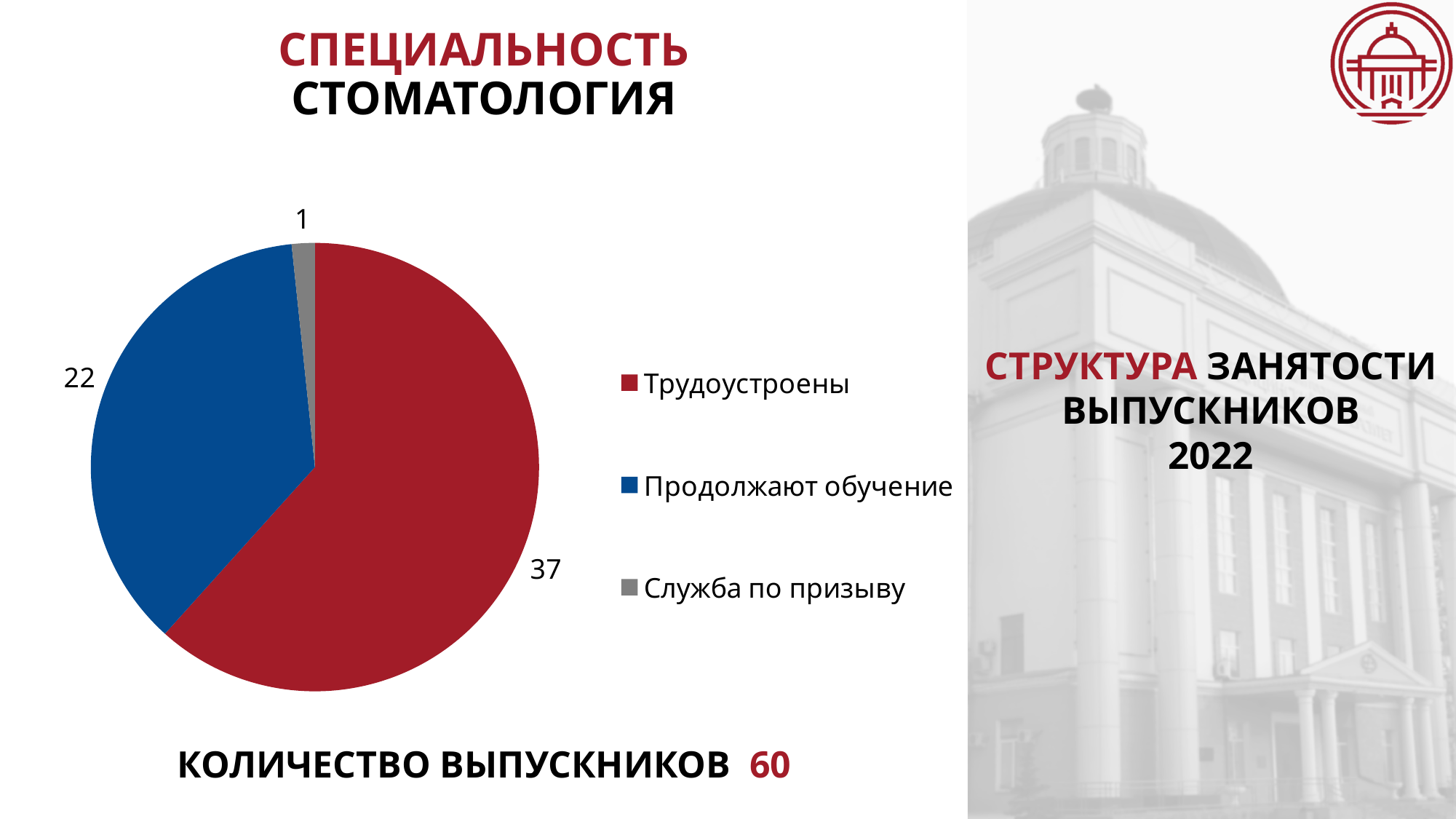
How many graduates are in the 'Трудоустроены' slice of the pie chart? 37 How many entries are listed in the chart legend? 3 Which category has the smallest slice in the pie chart? Служба по призыву What colour is the 'Продолжают обучение' slice in the pie chart? Blue What value is shown for 'Служба по призыву' in the pie chart? 1 How many categories does the pie chart show? 3 What value is shown for 'Продолжают обучение' in the pie chart? 22 What type of chart is shown on the slide? Pie chart Which is larger: 'Продолжают обучение' or 'Служба по призыву'? Продолжают обучение Which category has the largest slice in the pie chart? Трудоустроены What is the total of all slices in the pie chart? 60 What is the difference between the 'Трудоустроены' and 'Продолжают обучение' values? 15